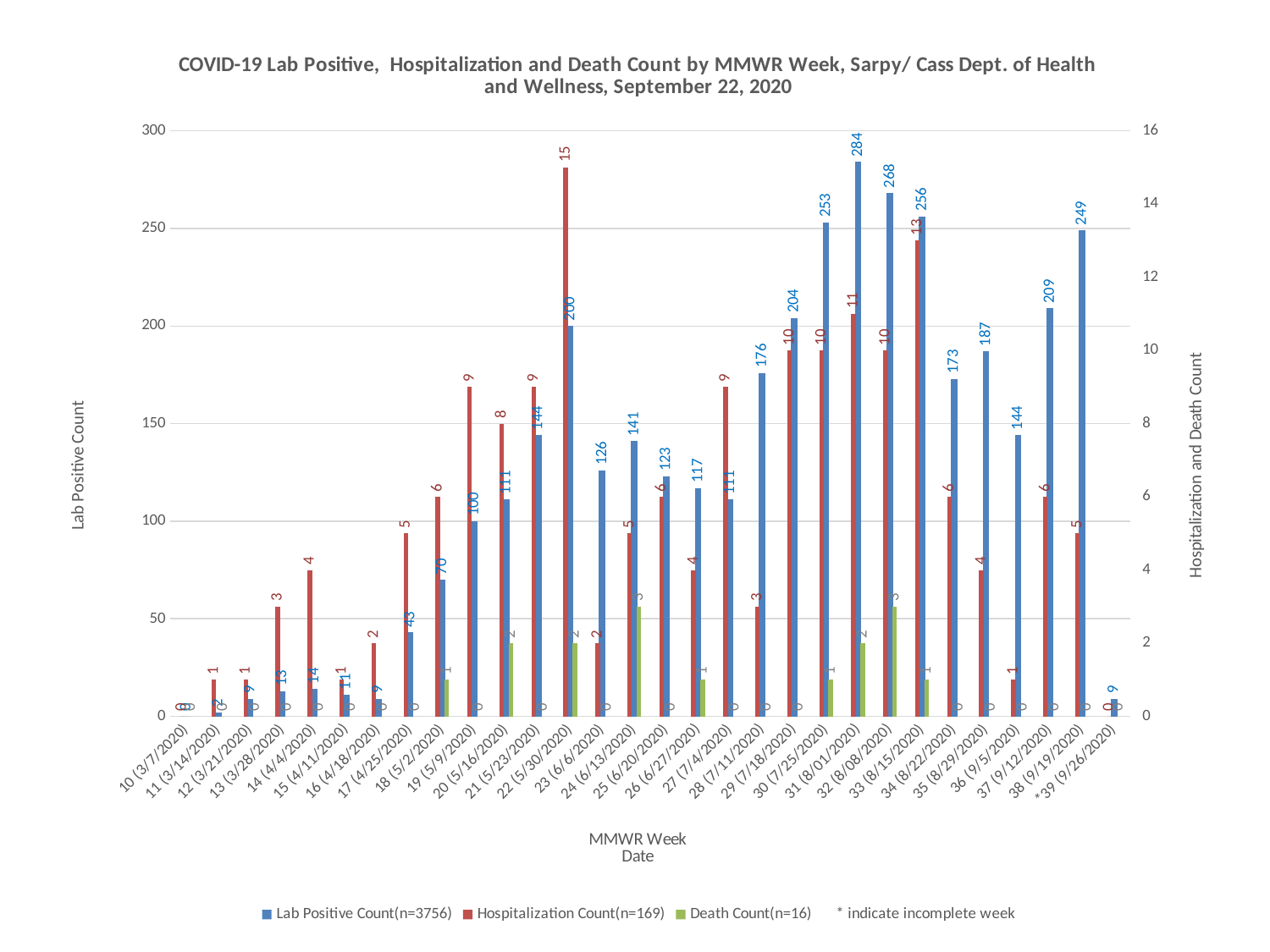
Which MMWR week has the highest Lab Positive Count? 31 (8/01/2020) How many data series does the legend list? 3 What is the difference in Lab Positive Count between week 31 (8/01/2020) and week 32 (8/08/2020)? 16 What is the Death Count for MMWR week 24 (6/13/2020)? 3 Which is larger, the Lab Positive Count for week 29 (7/18/2020) or for week 37 (9/12/2020)? 37 (9/12/2020) How many MMWR weeks are shown on the x axis? 30 According to the legend, what is the total n for the Hospitalization Count series? 169 What kind of chart is shown on the slide? Bar chart Does the Lab Positive Count rise or fall from week 17 (4/25/2020) to week 22 (5/30/2020)? Rise What is the Lab Positive Count for MMWR week 31 (8/01/2020)? 284 Which MMWR week has the highest Hospitalization Count? 22 (5/30/2020) What is the Hospitalization Count for MMWR week 22 (5/30/2020)? 15